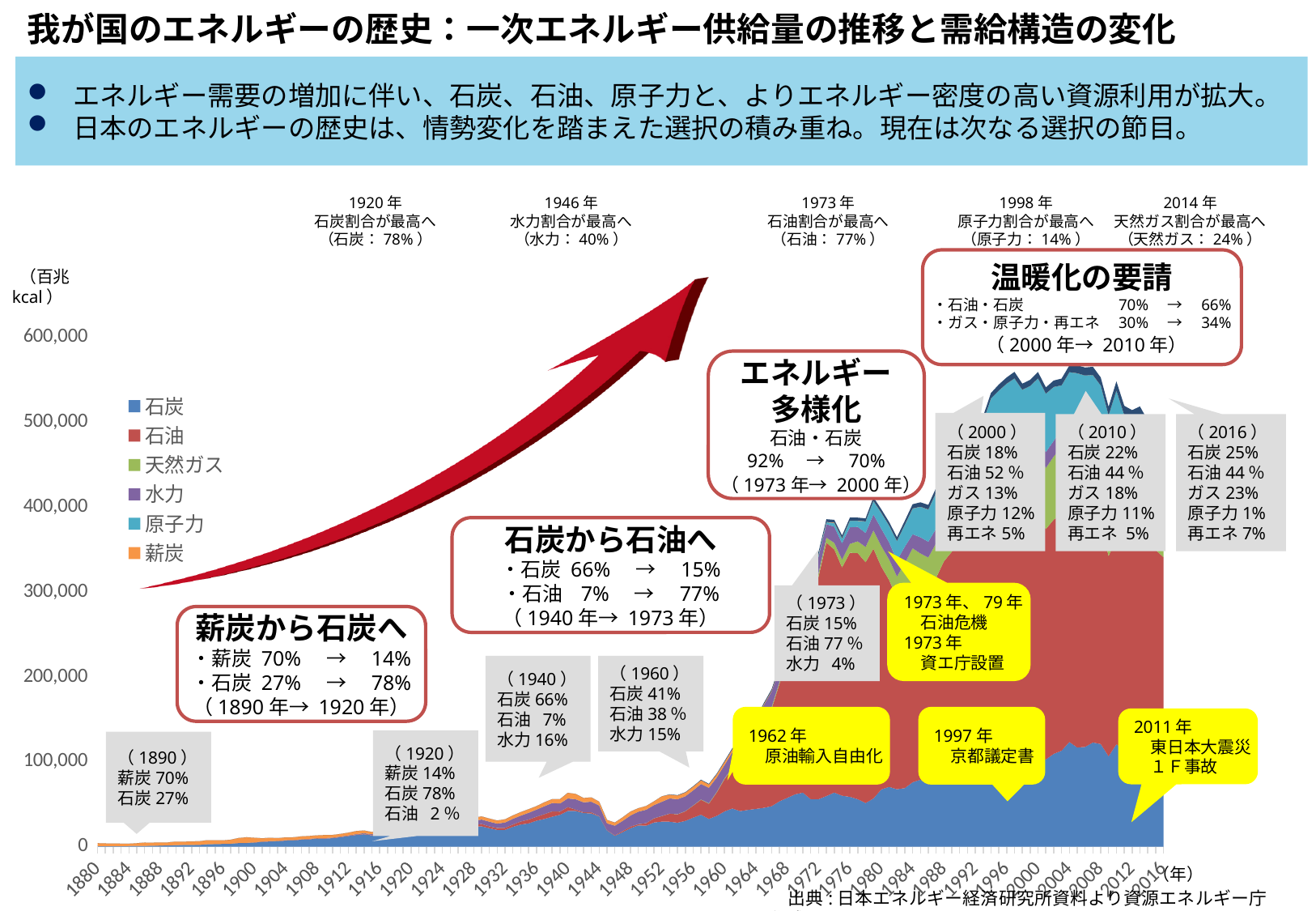
According to the annotation, what was the coal (石炭) share in 1920? 78% According to the 2016 annotation, which share is larger, 石油 or 石炭? 石油 According to the annotation, what was the oil (石油) share in 1973? 77% What unit is shown on the y axis of the chart? 百兆 kcal How many series does the chart legend list? 6 Which series is listed first in the chart legend? 石炭 Is the total energy supply in 2000 greater or less than 500,000? greater What kind of chart is shown on the slide? stacked area chart Is the total energy supply in 1880 greater or less than 100,000? less According to the 1973 annotation, what is the difference between the oil share (77%) and the coal share (15%)? 62% Does the total primary energy supply rise or fall from 1880 to around 2005? rise Is the total energy supply in 1960 greater or less than 200,000? less